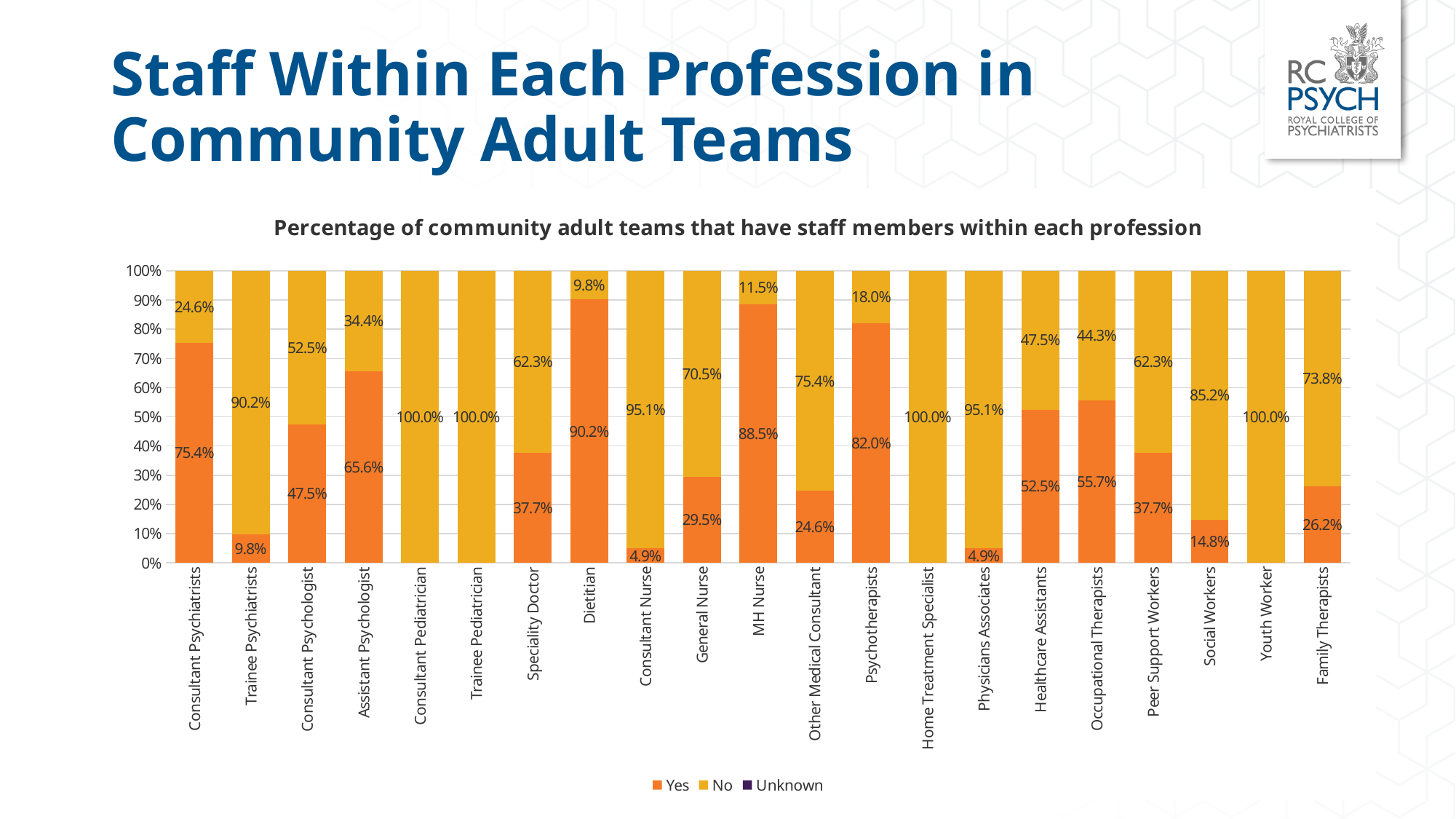
How many professions are shown on the x axis? 21 What is the "No" value for Social Workers? 85.2% Which has a larger "No" value: Trainee Psychiatrists or Family Therapists? Trainee Psychiatrists Which has a larger "Yes" value: Psychotherapists or Assistant Psychologist? Psychotherapists What is the total of the stacked bar for Healthcare Assistants? 100.0% What percentage of community adult teams answered "Yes" for Consultant Psychiatrists? 75.4% What is the difference between the "Yes" values for MH Nurse and General Nurse? 59.0% What is the title of the chart? Percentage of community adult teams that have staff members within each profession What kind of chart is shown on the slide? Stacked bar chart How many series does the legend list? 3 Which profession has the highest "Yes" percentage? Dietitian What is the "Yes" value for Occupational Therapists? 55.7%